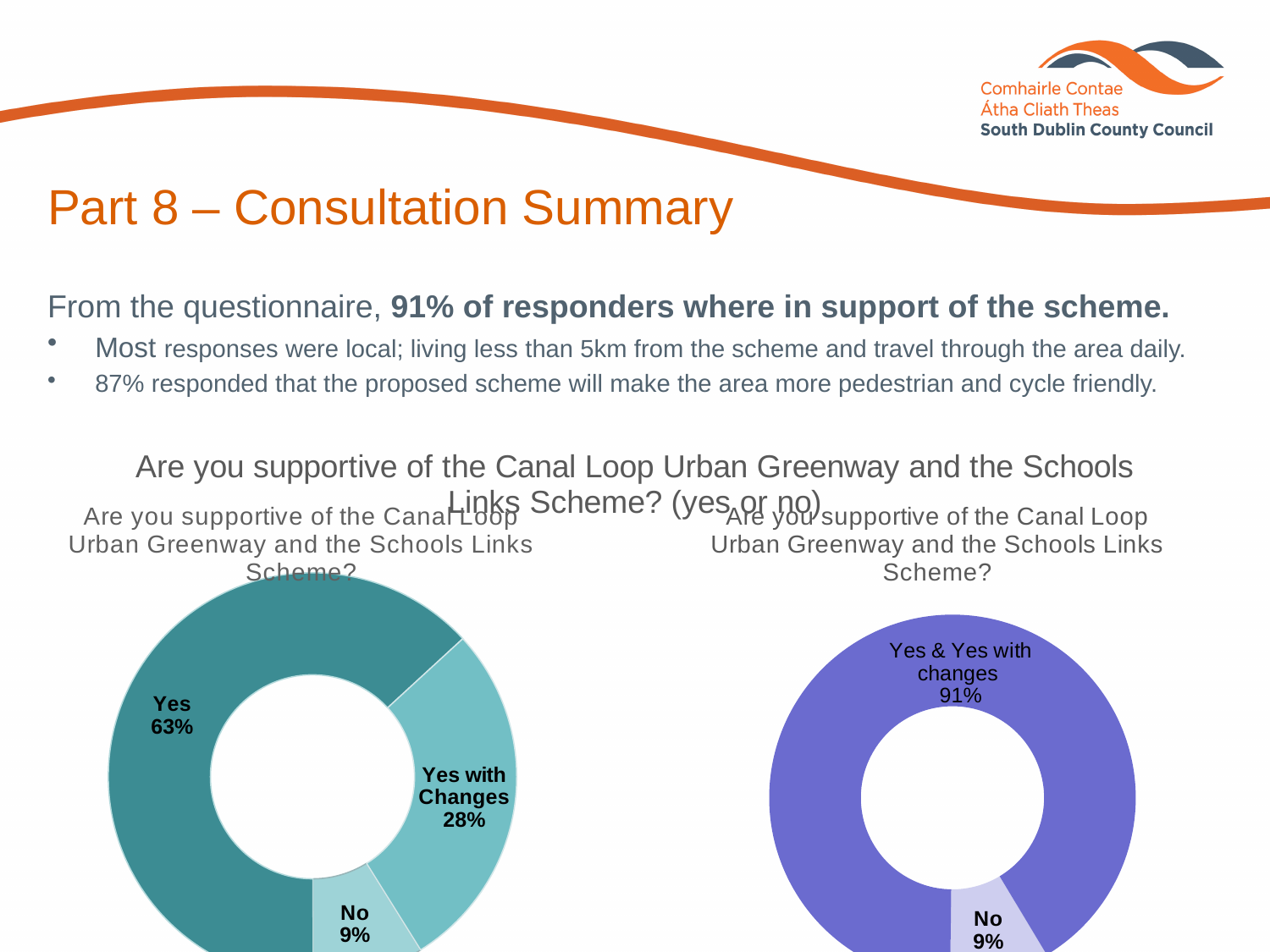
In the left chart, which is larger: the share for Yes with Changes or the share for No? Yes with Changes In the right chart, what percentage is shown for Yes & Yes with changes? 91% In the left chart, which response has the largest share? Yes How many segments does the left chart have? 3 In the left chart, what is the difference in percentage points between Yes and Yes with Changes? 35 In the left chart, what percentage of respondents answered Yes with Changes? 28% In the right chart, what is the difference in percentage points between Yes & Yes with changes and No? 82 In the left chart, what percentage of respondents answered Yes? 63% In the right chart, what percentage is shown for No? 9% In the left chart, what percentage of respondents answered No? 9% What type of chart is the right chart? Doughnut chart In the left chart, which response has the smallest share? No